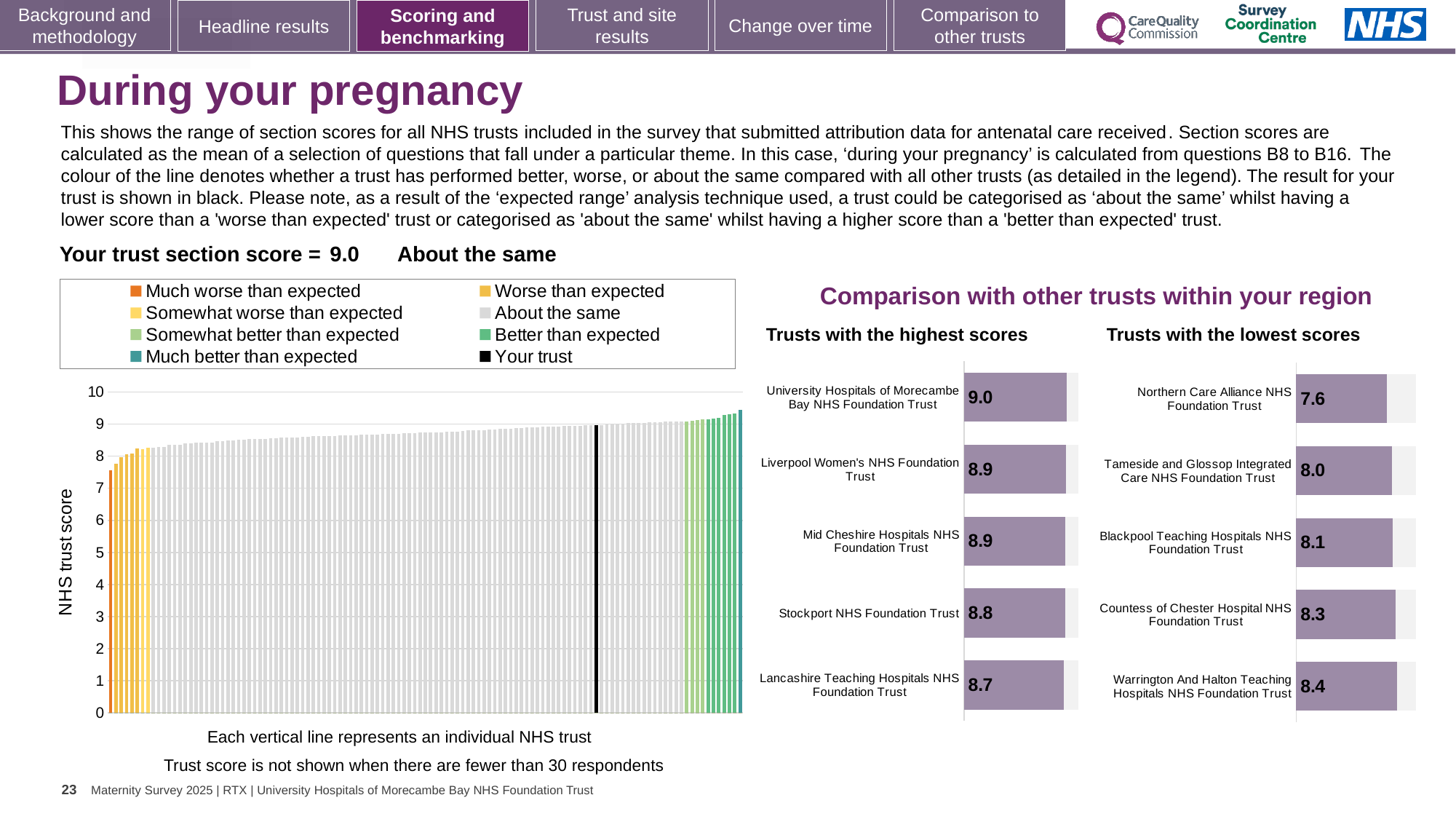
In the 'Trusts with the highest scores' chart, what is the difference between the scores of University Hospitals of Morecambe Bay NHS Foundation Trust and Lancashire Teaching Hospitals NHS Foundation Trust? 0.3 In the 'NHS trust score' chart on the left, what is the section score for your trust (the black bar)? 9.0 In the 'Trusts with the lowest scores' chart, what is the score for Northern Care Alliance NHS Foundation Trust? 7.6 In the 'Trusts with the highest scores' chart, which trust has the highest score? University Hospitals of Morecambe Bay NHS Foundation Trust How many entries does the legend of the 'NHS trust score' chart on the left list? 8 In the 'Trusts with the lowest scores' chart, which has the larger score: Tameside and Glossop Integrated Care NHS Foundation Trust or Warrington And Halton Teaching Hospitals NHS Foundation Trust? Warrington And Halton Teaching Hospitals NHS Foundation Trust What kind of chart is the 'NHS trust score' chart on the left of the slide? Bar chart In the 'Trusts with the highest scores' chart, what is the score for Stockport NHS Foundation Trust? 8.8 In the 'Trusts with the lowest scores' chart, what is the score for Countess of Chester Hospital NHS Foundation Trust? 8.3 In the 'Trusts with the lowest scores' chart, which trust has the lowest score? Northern Care Alliance NHS Foundation Trust In the 'Trusts with the highest scores' chart, what is the score for University Hospitals of Morecambe Bay NHS Foundation Trust? 9.0 How many trusts are shown in the 'Trusts with the lowest scores' chart? 5